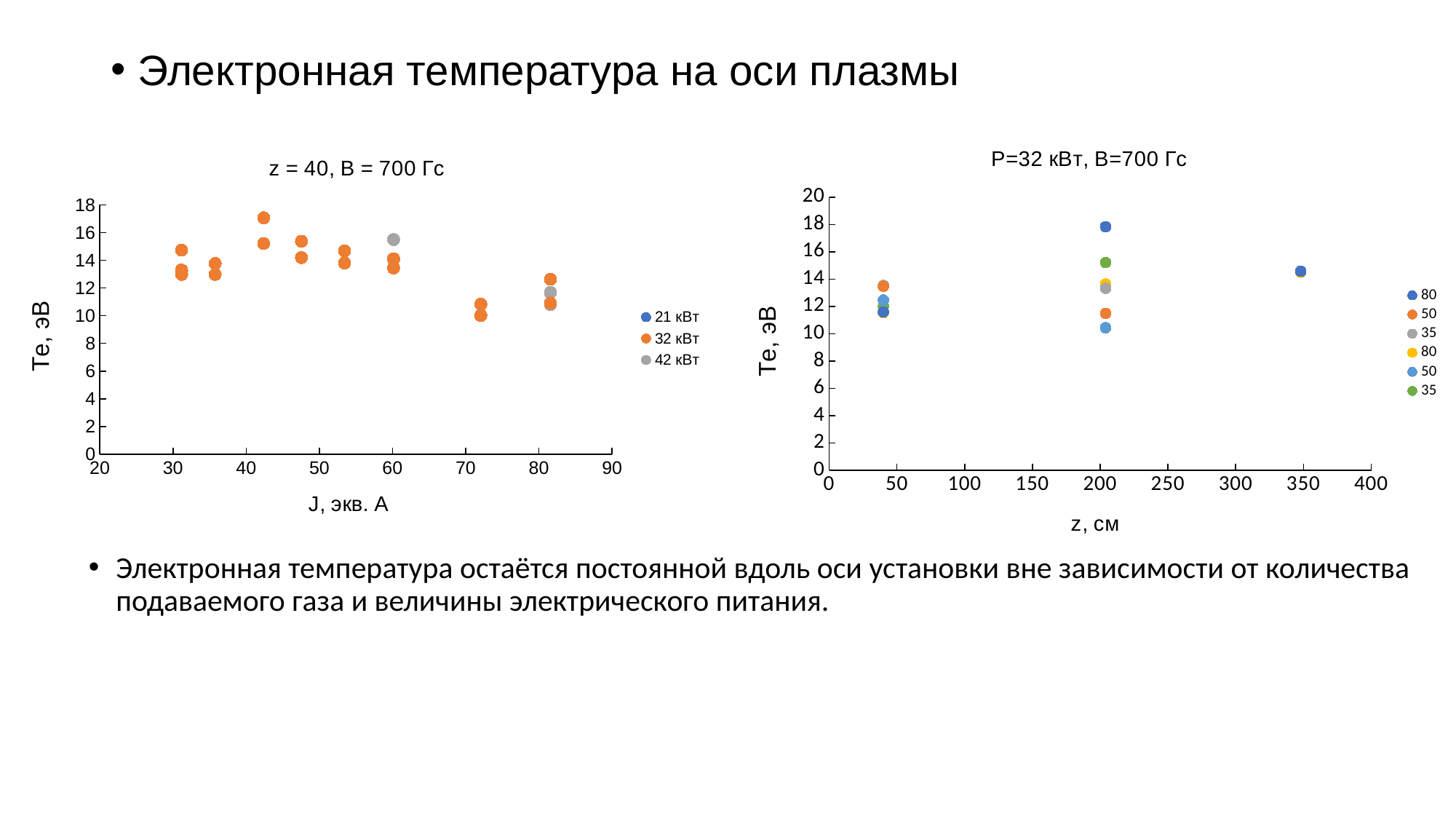
How many entries does the legend of the right chart (P=32 кВт, B=700 Гс) list? 6 In the right chart (P=32 кВт, B=700 Гс), is the highest point near z = 200 greater or less than 16 эВ? greater In the left chart (z = 40, B = 700 Гс), which is higher: the 32 кВт points near J = 42 or the 32 кВт points near J = 72? near J = 42 How many series does the legend of the left chart (z = 40, B = 700 Гс) list? 3 What is the x-axis label of the left chart (z = 40, B = 700 Гс)? J, экв. А In the right chart (P=32 кВт, B=700 Гс), is the point near z = 350 greater or less than 12 эВ? greater In the right chart (P=32 кВт, B=700 Гс), is the lowest point near z = 200 greater or less than 12 эВ? less What kind of chart is the left chart titled "z = 40, B = 700 Гс"? scatter chart What is the x-axis label of the right chart (P=32 кВт, B=700 Гс)? z, см What kind of chart is the right chart titled "P=32 кВт, B=700 Гс"? scatter chart